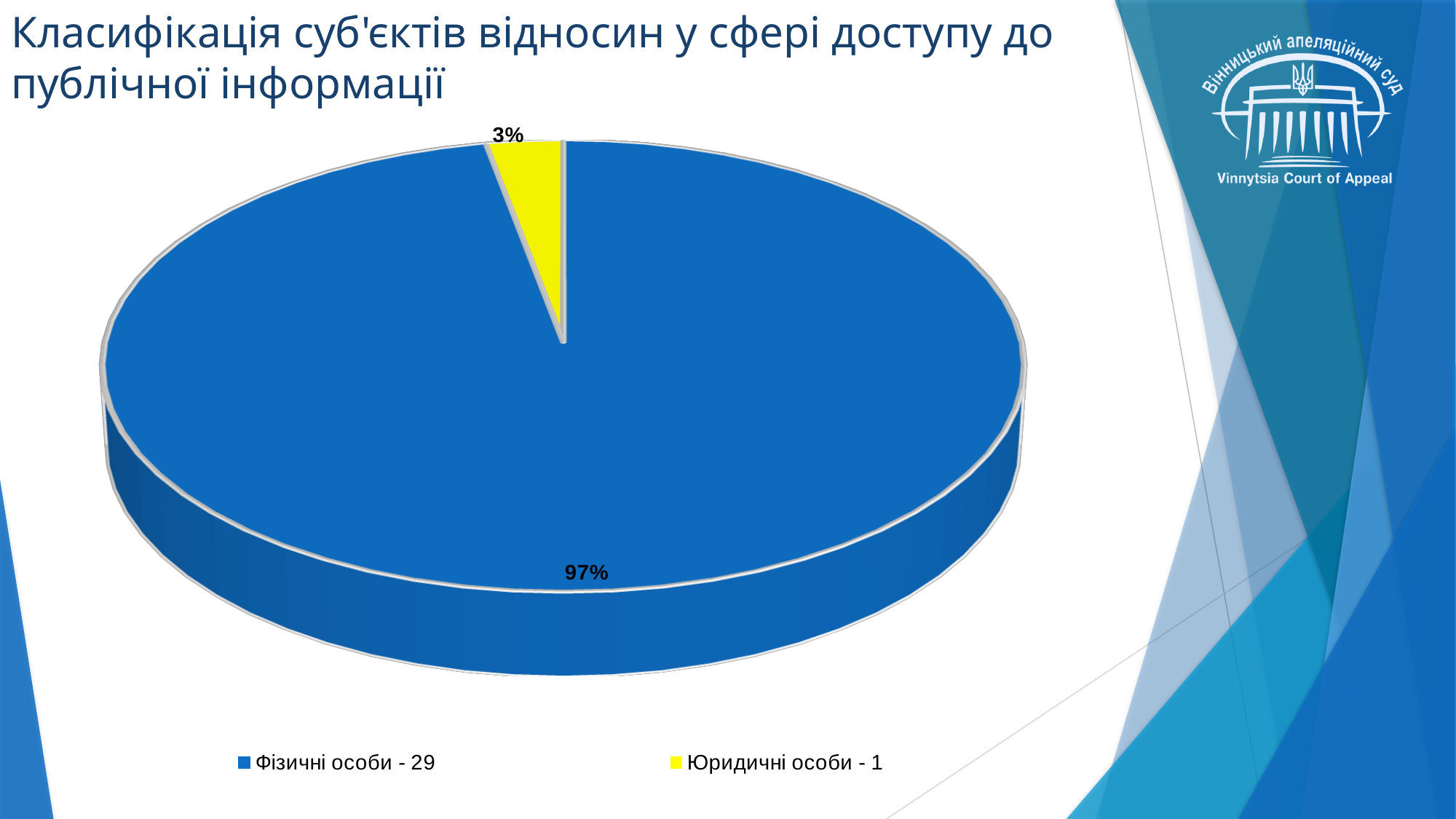
What number is shown next to "Фізичні особи" in the legend? 29 How many entries does the legend list? 2 What kind of chart is shown on the slide? pie chart What share of the pie does "Юридичні особи" take? 3% What number is shown next to "Юридичні особи" in the legend? 1 What is the difference in percentage points between the "Фізичні особи" slice and the "Юридичні особи" slice? 94 percentage points Which is larger: the share for "Фізичні особи" or the share for "Юридичні особи"? Фізичні особи Which category has the smallest slice of the pie? Юридичні особи How many slices does the pie chart have? 2 What share of the pie does "Фізичні особи" take? 97% Which category has the largest slice of the pie? Фізичні особи What colour is the slice for "Юридичні особи"? yellow